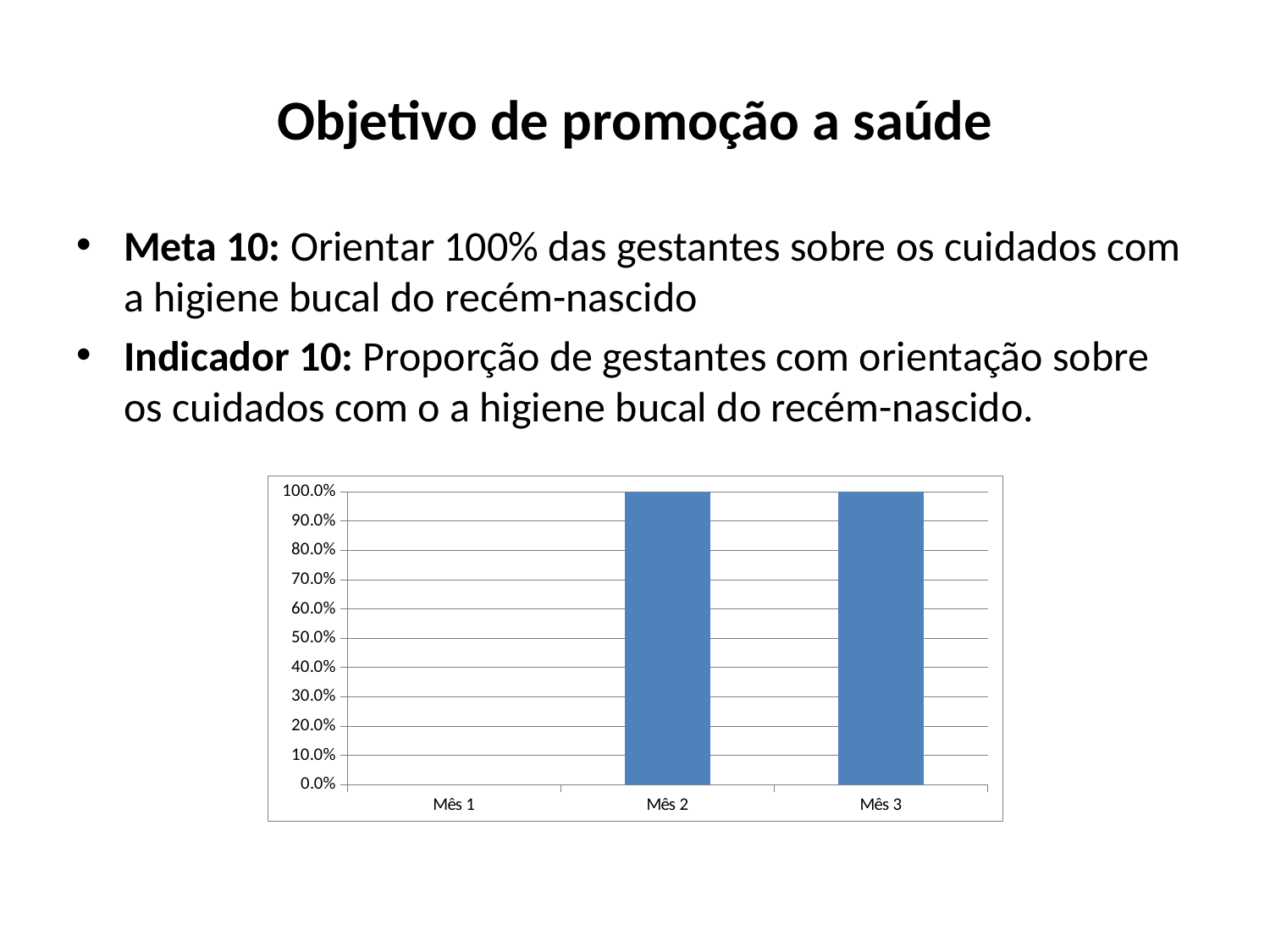
Which categories reach 100.0% in the chart? Mês 2 and Mês 3 Which is larger, the value for Mês 1 or the value for Mês 2? Mês 2 What is the highest value labelled on the vertical axis of the chart? 100.0% What is the value for Mês 2 in the chart? 100.0% Is the value for Mês 3 greater or less than 50.0%? greater What is the value for Mês 1 in the chart? 0.0% Does the value rise or fall from Mês 1 to Mês 2? rise What kind of chart is shown on the slide? bar chart How many categories are shown on the x axis of the chart? 3 What is the difference between the values for Mês 2 and Mês 1? 100.0% Which category has the lowest value in the chart? Mês 1 What is the value for Mês 3 in the chart? 100.0%